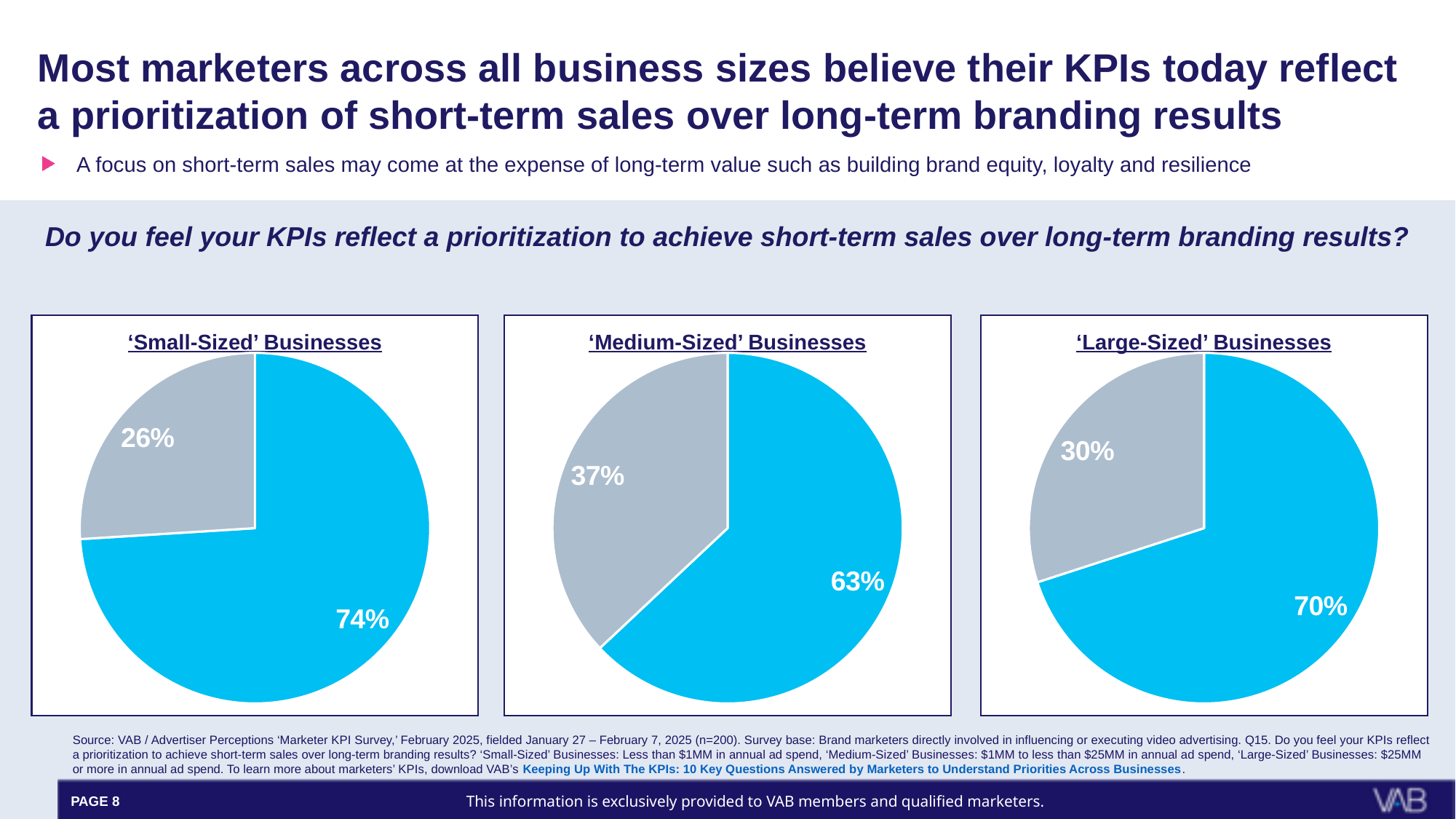
In the 'Small-Sized' Businesses pie chart, what value is shown on the grey slice? 26% In the 'Medium-Sized' Businesses pie chart, what value is shown on the blue slice? 63% What kind of chart is used for the 'Small-Sized' Businesses panel? Pie chart Across the three pie charts, which business size has the smallest blue slice? 'Medium-Sized' Businesses What is the difference between the blue slice in the 'Small-Sized' Businesses pie chart and the blue slice in the 'Medium-Sized' Businesses pie chart? 11 percentage points In the 'Medium-Sized' Businesses pie chart, what value is shown on the grey slice? 37% Which is larger: the grey slice in the 'Large-Sized' Businesses pie chart or the grey slice in the 'Small-Sized' Businesses pie chart? 'Large-Sized' Businesses In the 'Large-Sized' Businesses pie chart, what value is shown on the grey slice? 30% In the 'Large-Sized' Businesses pie chart, what value is shown on the blue slice? 70% How many pie charts are shown on the slide? 3 Across the three pie charts, which business size has the largest blue slice? 'Small-Sized' Businesses In the 'Small-Sized' Businesses pie chart, what value is shown on the blue slice? 74%